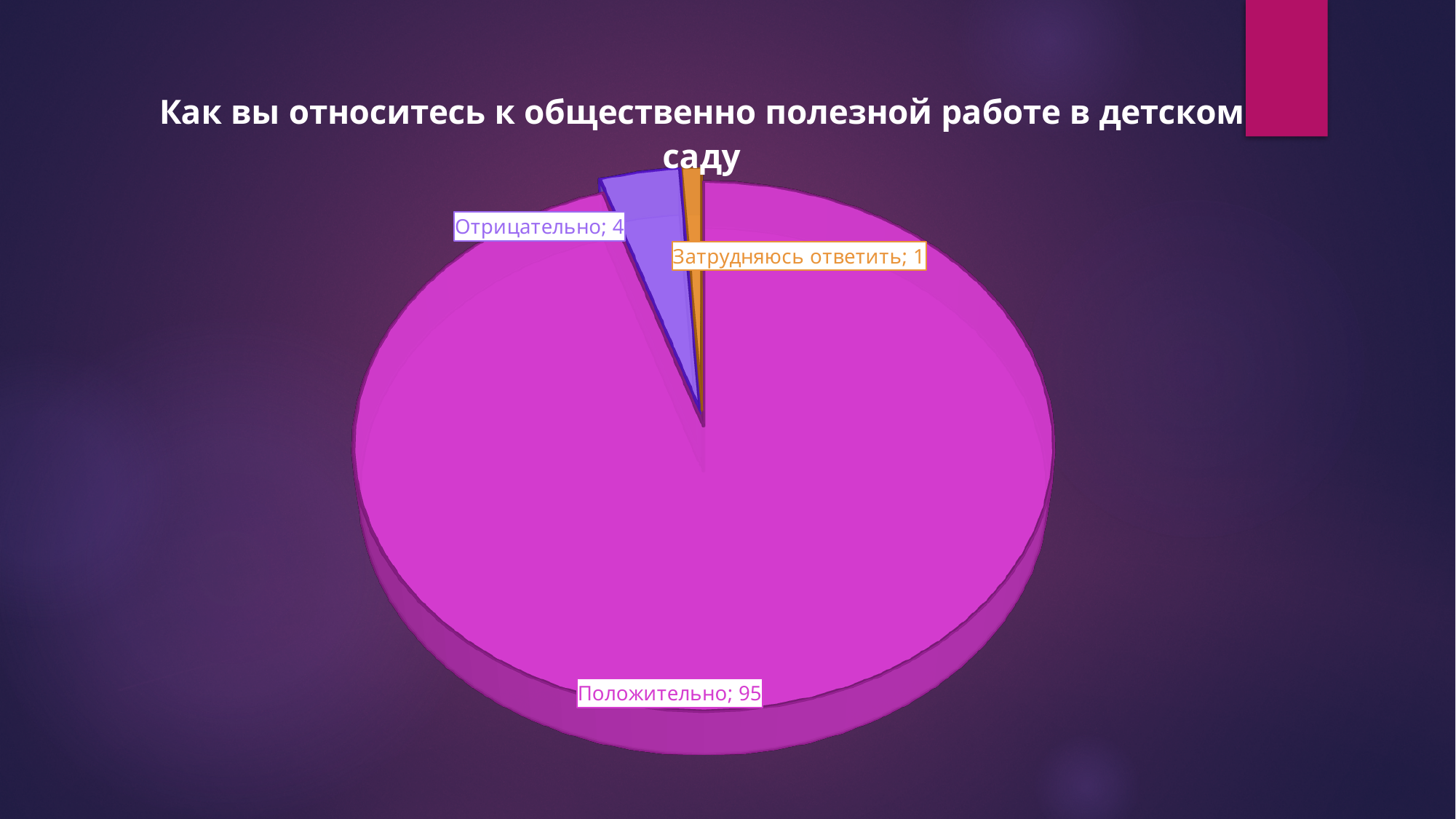
What kind of chart is shown on the slide? pie chart What is the difference between the values for Положительно and Отрицательно? 91 What is the value for Отрицательно? 4 What is the value for Затрудняюсь ответить? 1 What is the difference between the values for Отрицательно and Затрудняюсь ответить? 3 What is the title of the chart? Как вы относитесь к общественно полезной работе в детском саду Which is larger, the value for Отрицательно or the value for Затрудняюсь ответить? Отрицательно What is the value for Положительно? 95 How many slices does the pie chart have? 3 What share of the pie does Положительно represent? 95% Which category has the largest slice? Положительно Which category has the smallest slice? Затрудняюсь ответить